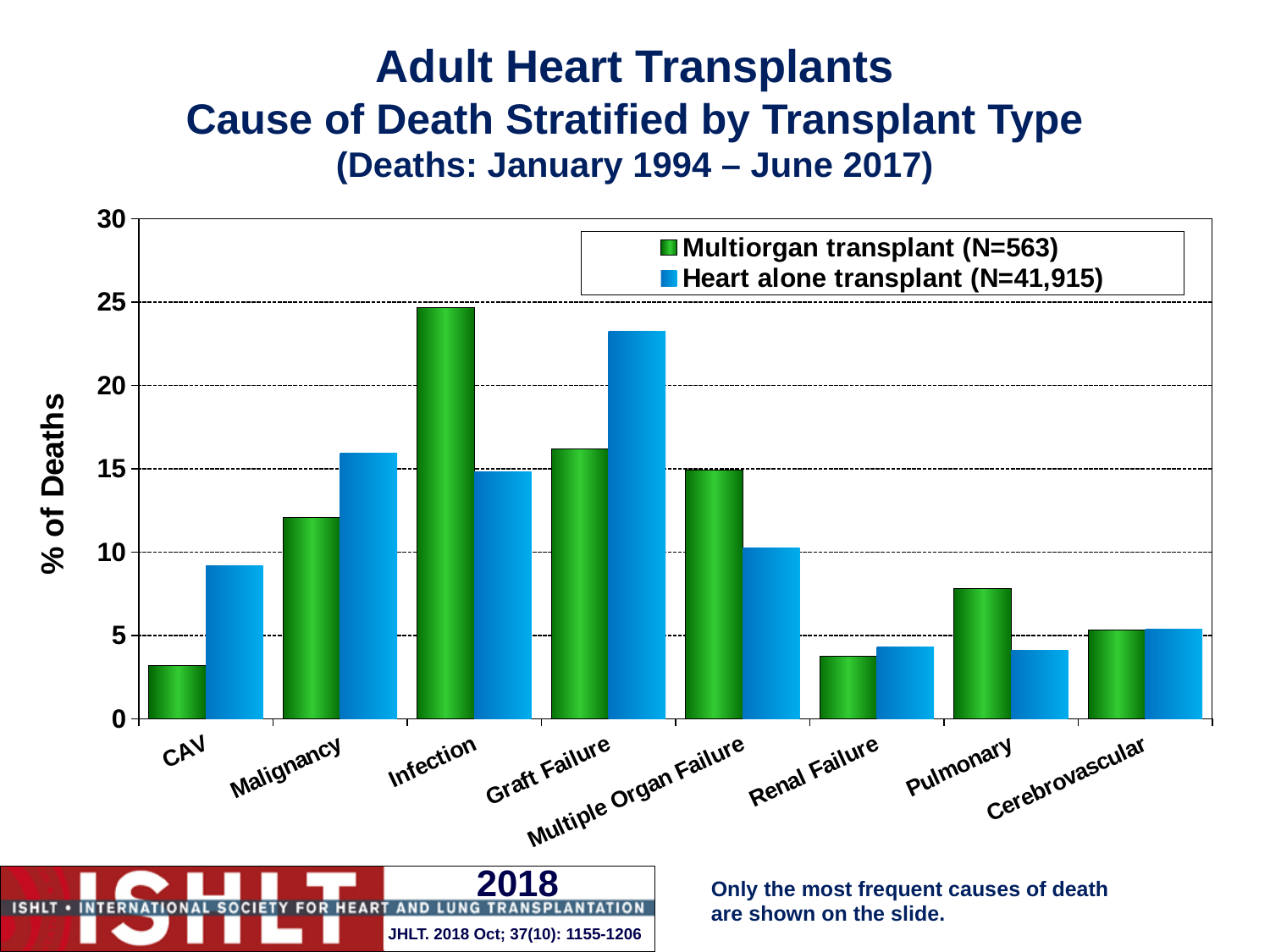
For CAV, which series has the larger value: Multiorgan transplant or Heart alone transplant? Heart alone transplant Is the Multiorgan transplant value for CAV greater or less than 5? less How many series does the legend list? 2 How many causes of death are shown on the x axis? 8 What is the label on the y axis? % of Deaths Is the Multiorgan transplant value for Infection greater or less than 20? greater Which cause of death has the highest percentage for the Multiorgan transplant series? Infection For Graft Failure, which series has the larger value: Multiorgan transplant or Heart alone transplant? Heart alone transplant Is the Heart alone transplant value for Graft Failure greater or less than 20? greater Which cause of death has the highest percentage for the Heart alone transplant series? Graft Failure What kind of chart is shown on the slide? bar chart